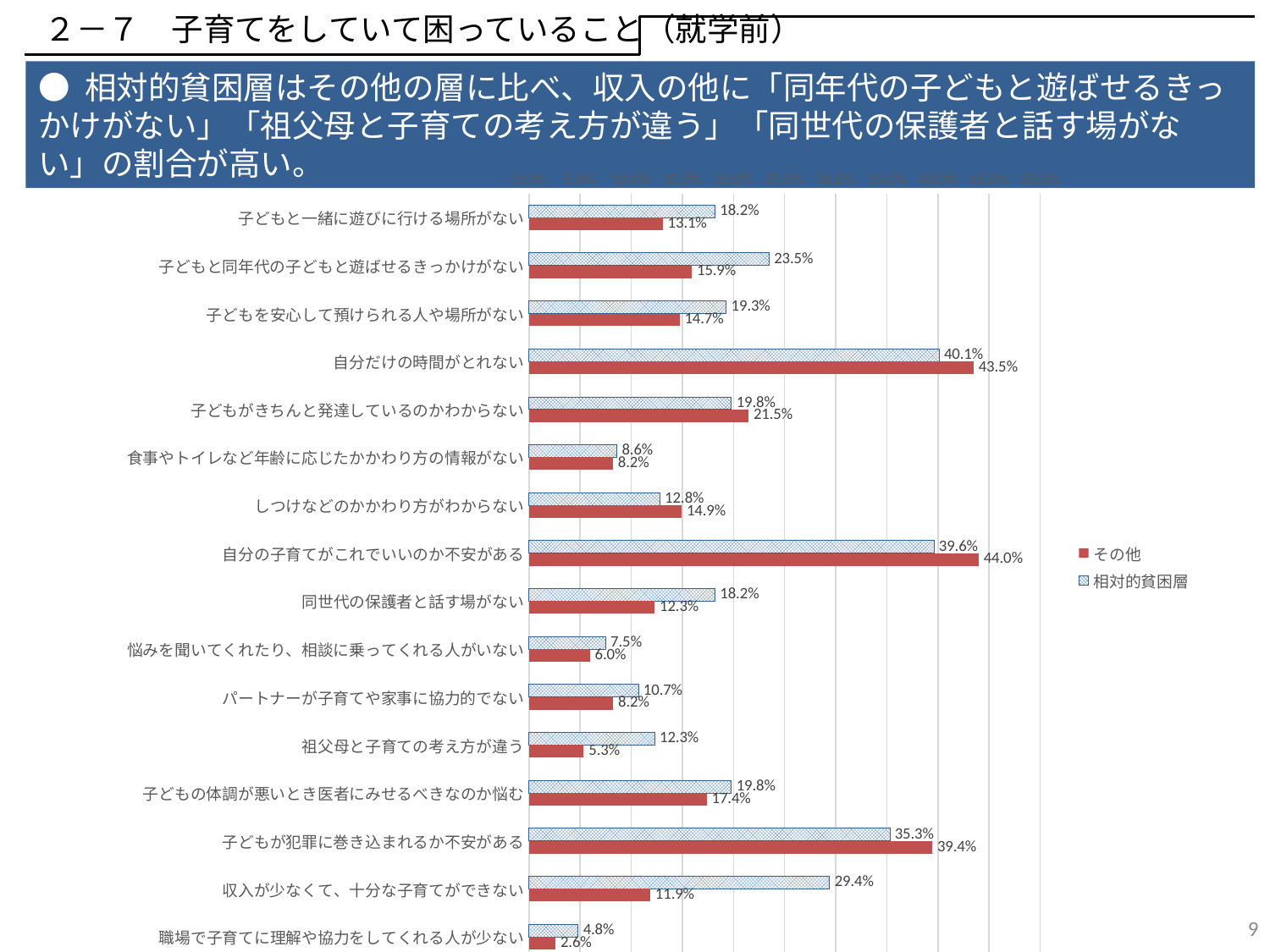
Which series is shown in red on the chart? その他 Which category has the highest value for その他? 自分の子育てがこれでいいのか不安がある Which category has the highest value for 相対的貧困層? 自分だけの時間がとれない What is the value for その他 in the category 祖父母と子育ての考え方が違う? 5.3% Which category has the lowest value for その他? 職場で子育てに理解や協力をしてくれる人が少ない What type of chart is shown on the slide? Bar chart What is the difference between 相対的貧困層 and その他 in the category 収入が少なくて、十分な子育てができない? 17.5 percentage points What is the value for 相対的貧困層 in the category 子どもと同年代の子どもと遊ばせるきっかけがない? 23.5% How many categories are plotted on the chart? 16 In the category 自分だけの時間がとれない, which series has the larger value, その他 or 相対的貧困層? その他 What is the value for 相対的貧困層 in the category 収入が少なくて、十分な子育てができない? 29.4% How many series does the legend list? 2